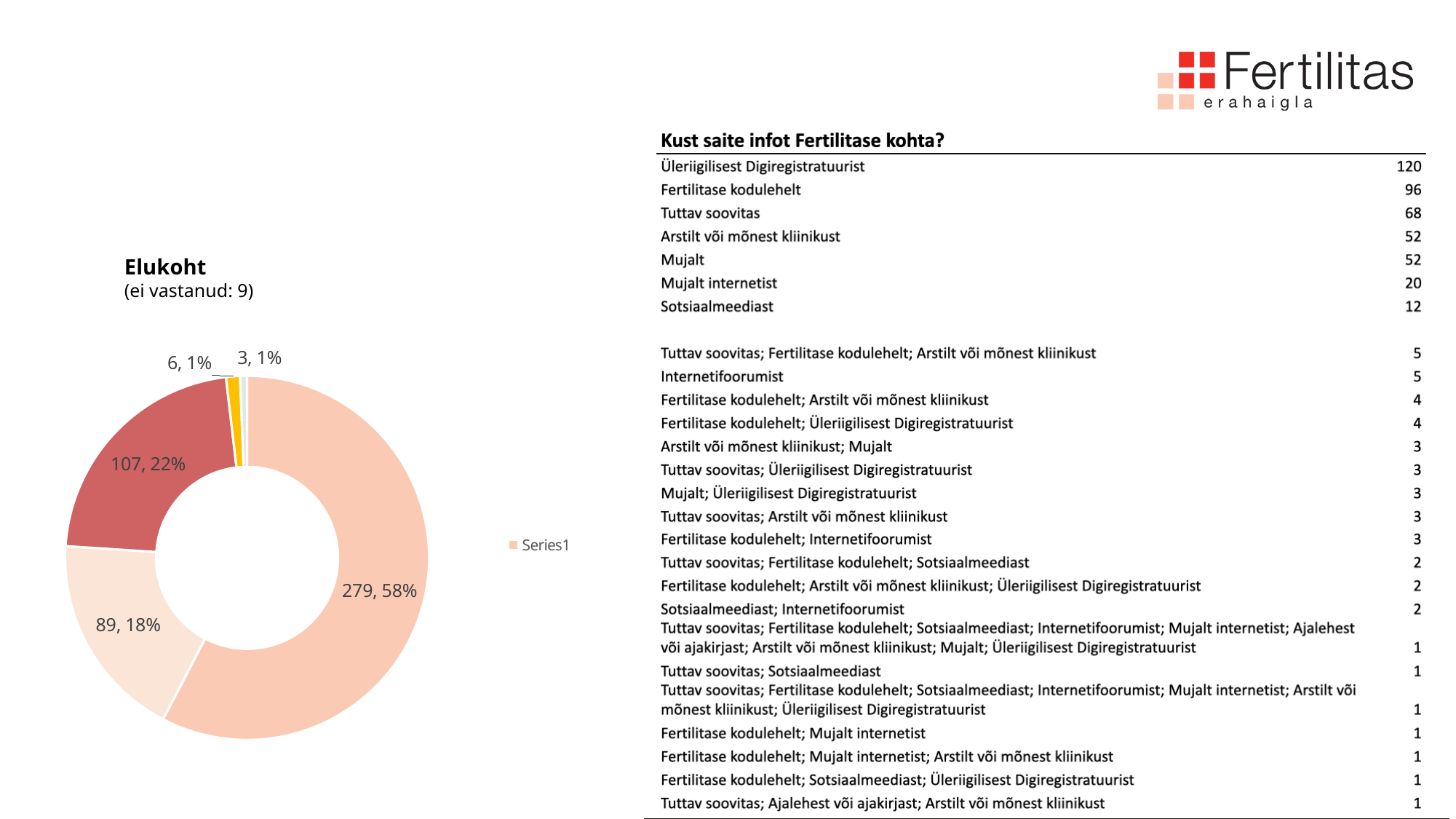
What share of the Elukoht chart does the slice with value 89 represent? 18% What type of chart is shown on the slide? doughnut (pie) chart Which is larger in the Elukoht chart: the slice with value 107 or the slice with value 89? 107 What share of the Elukoht chart does the slice with value 107 represent? 22% How many slices does the Elukoht chart have? 5 What is the value of the largest slice in the Elukoht chart? 279 What is the value of the smallest slice in the Elukoht chart? 3 What is the title of the chart on the slide? Elukoht What is the total of all slice values in the Elukoht chart? 484 What share of the Elukoht chart does the largest slice represent? 58% What is the difference between the largest slice (279) and the second largest slice (107) in the Elukoht chart? 172 How many series does the legend of the Elukoht chart list? 1